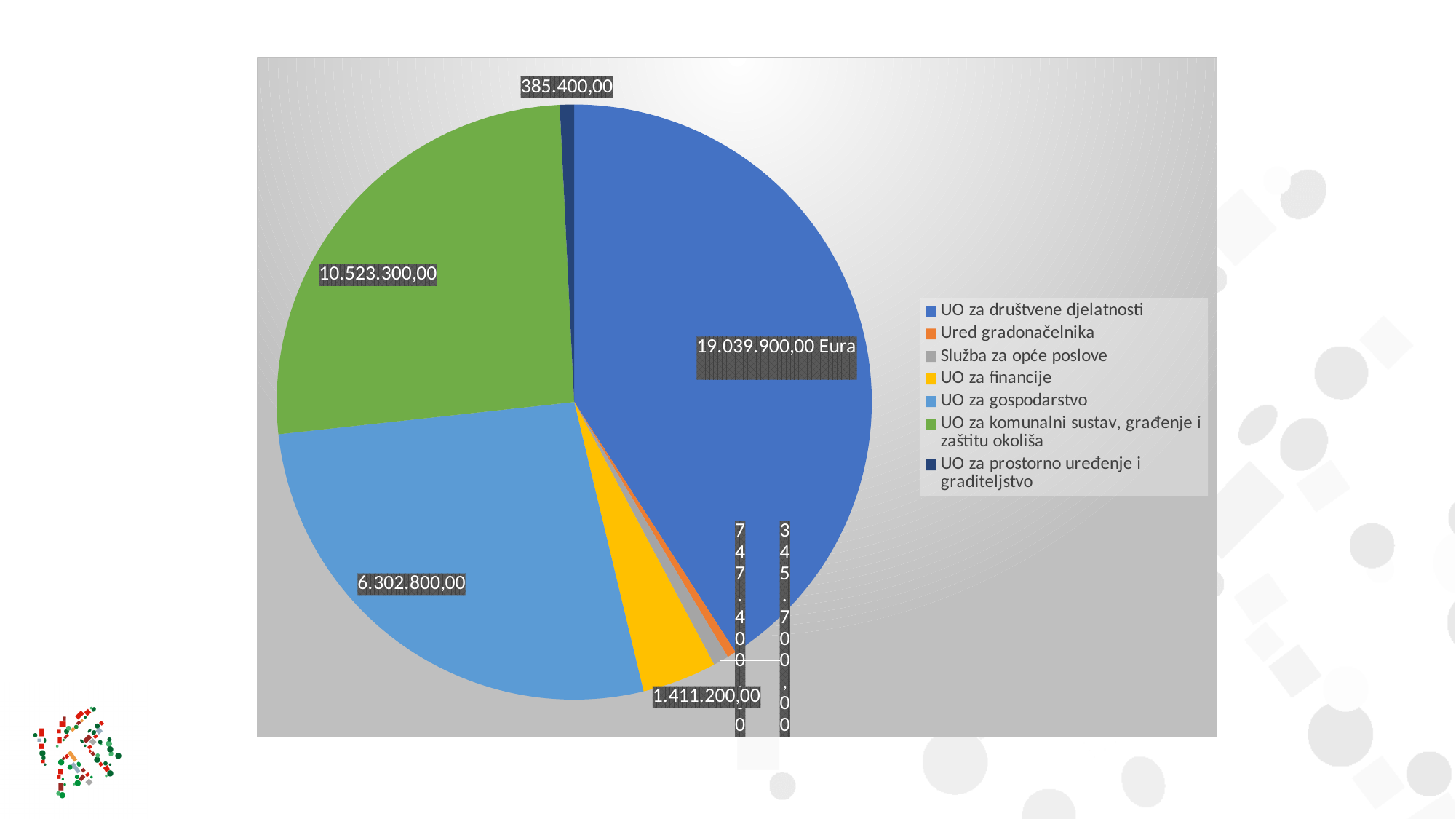
What is the value shown for UO za financije? 1.411.200,00 What is the value shown for UO za komunalni sustav, građenje i zaštitu okoliša? 10.523.300,00 How many categories does the legend list? 7 What colour is the slice for UO za financije? yellow What is the value shown for UO za gospodarstvo? 6.302.800,00 What is the value shown for UO za prostorno uređenje i graditeljstvo? 385.400,00 Which category has the largest slice of the pie? UO za društvene djelatnosti What is the value shown for UO za društvene djelatnosti? 19.039.900,00 Eura What is the difference between the values for UO za društvene djelatnosti and UO za komunalni sustav, građenje i zaštitu okoliša? 8.516.600,00 What kind of chart is shown on the slide? pie chart Which is larger, the slice for UO za komunalni sustav, građenje i zaštitu okoliša or the slice for UO za gospodarstvo? UO za komunalni sustav, građenje i zaštitu okoliša What is the difference between the values for UO za gospodarstvo and UO za financije? 4.891.600,00